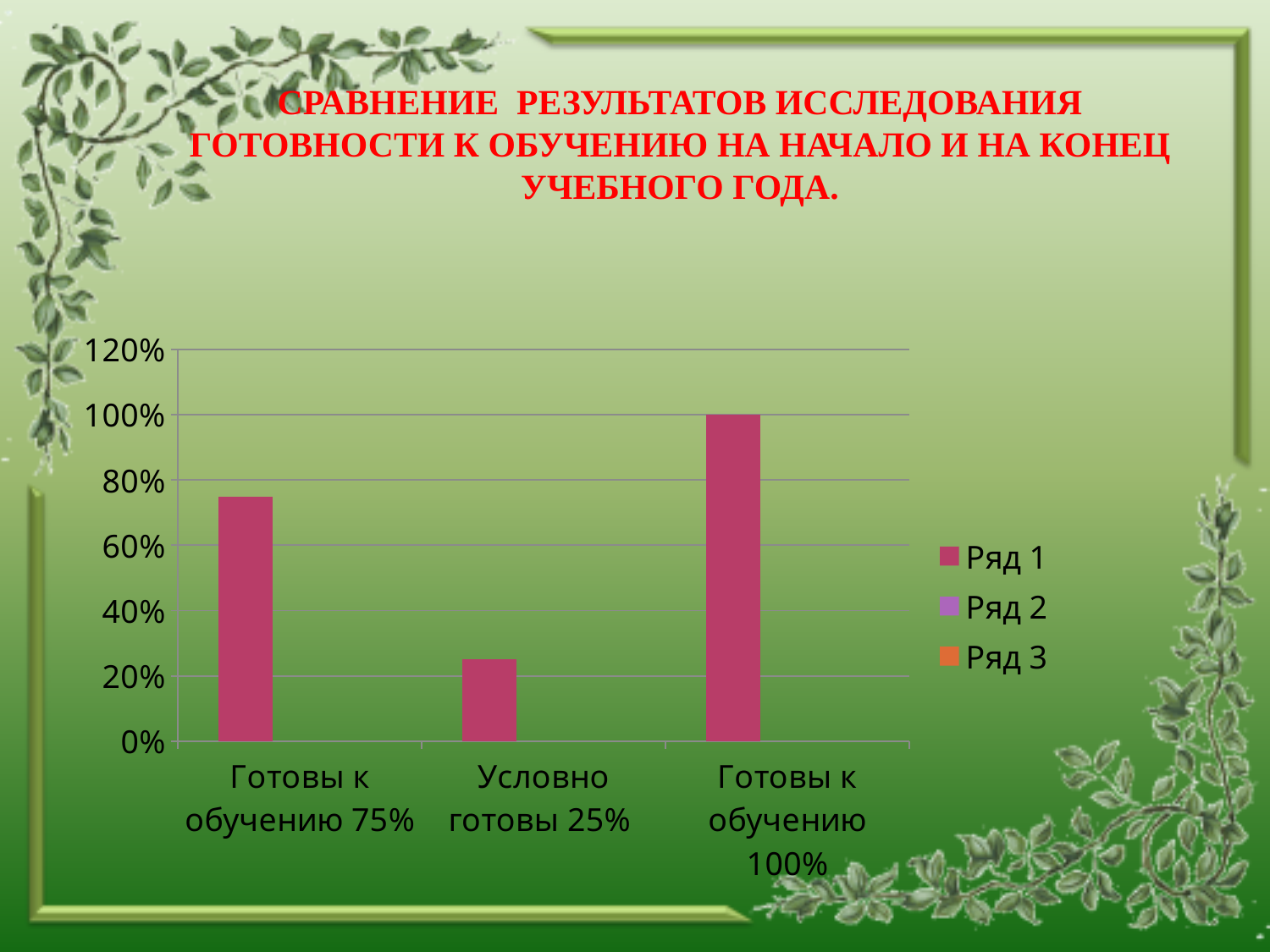
What is the value of the bar for the category "Условно готовы 25%"? 25% Which is larger: the bar for "Готовы к обучению 75%" or the bar for "Условно готовы 25%"? Готовы к обучению 75% What type of chart is shown on the slide? bar chart What is the name of the first series in the chart legend? Ряд 1 Which category has the lowest bar? Условно готовы 25% What is the value of the bar for the category "Готовы к обучению 75%"? 75% Which category has the highest bar? Готовы к обучению 100% What is the difference between the bars for "Готовы к обучению 100%" and "Готовы к обучению 75%"? 25% How many categories are shown on the x axis of the chart? 3 Is the value for "Готовы к обучению 75%" greater or less than 60%? greater What is the value of the bar for the category "Готовы к обучению 100%"? 100% How many series does the chart legend list? 3